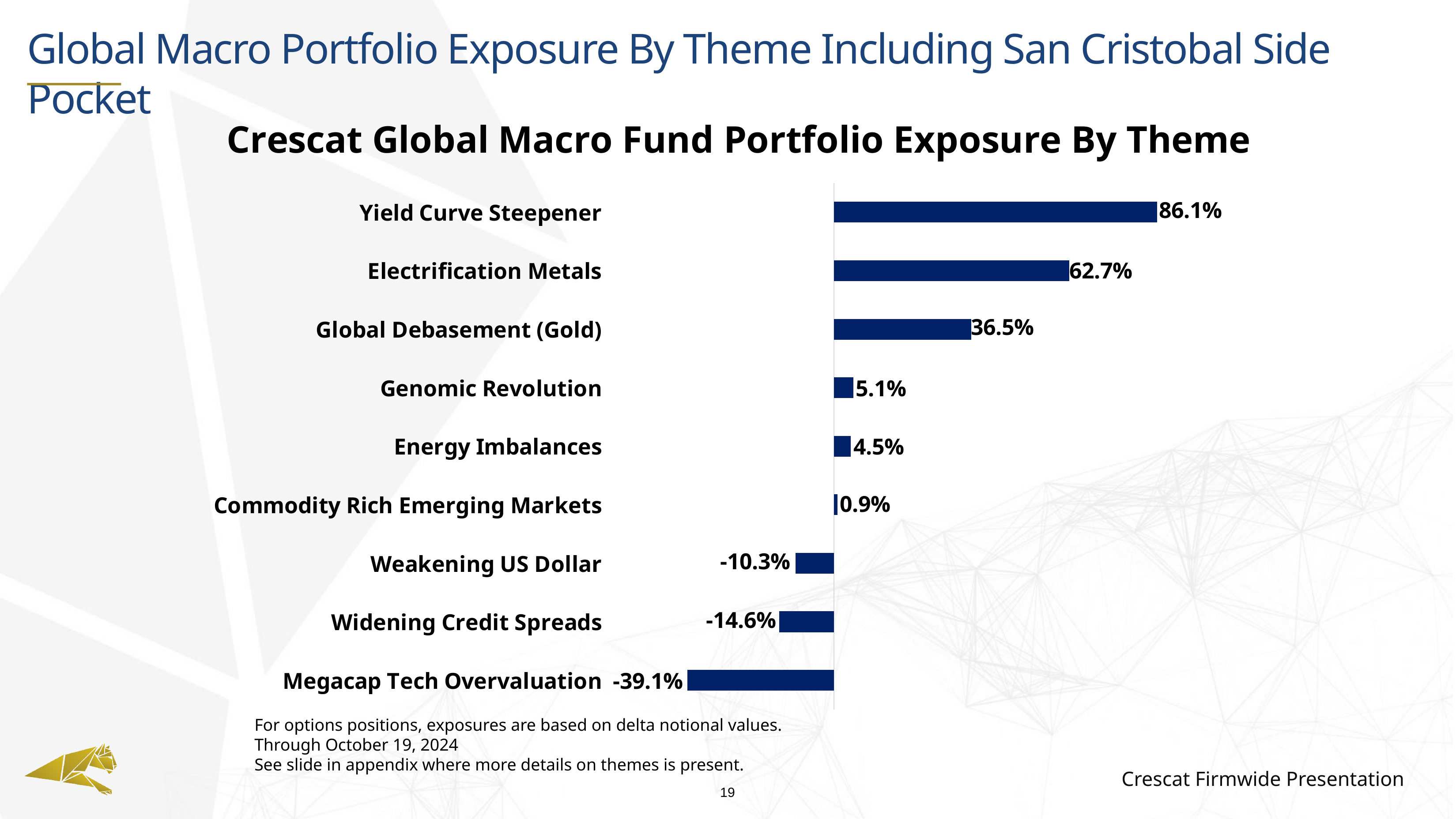
What is the exposure for Commodity Rich Emerging Markets? 0.9% What is the title of the chart? Crescat Global Macro Fund Portfolio Exposure By Theme What is the difference between the exposures for Yield Curve Steepener and Electrification Metals? 23.4% What is the exposure for Megacap Tech Overvaluation? -39.1% Which theme has the lowest exposure? Megacap Tech Overvaluation What kind of chart is shown on the slide? Bar chart What is the exposure for Yield Curve Steepener? 86.1% What is the difference between the exposures for Widening Credit Spreads and Weakening US Dollar? 4.3% What is the exposure for Global Debasement (Gold)? 36.5% Which has a larger exposure, Electrification Metals or Global Debasement (Gold)? Electrification Metals Which theme has the highest exposure? Yield Curve Steepener How many themes are shown in the chart? 9